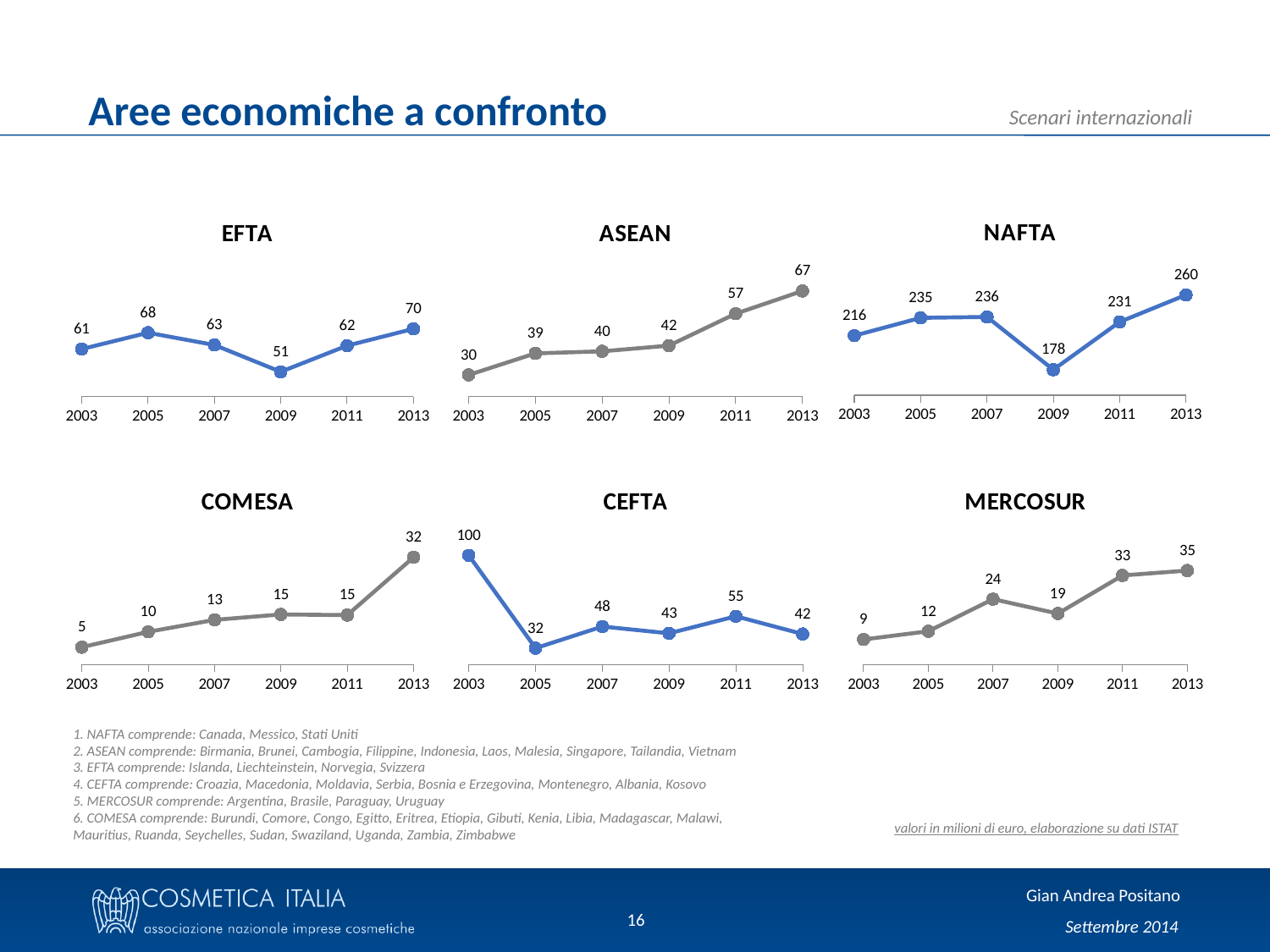
In the COMESA chart, which year has the highest value? 2013 In the CEFTA chart, what is the value for 2003? 100 In the MERCOSUR chart, what is the difference between the 2013 value and the 2003 value? 26 In the ASEAN chart, what is the value for 2013? 67 In the EFTA chart, what is the value for 2009? 51 How many data points are plotted in the ASEAN chart? 6 In the ASEAN chart, do the values rise or fall from 2003 to 2013? rise In the CEFTA chart, is the value for 2011 larger or smaller than the value for 2013? larger In the NAFTA chart, what is the difference between the 2013 value and the 2009 value? 82 How many charts are shown on the slide? 6 What kind of chart is the EFTA chart? line chart In the NAFTA chart, which year has the lowest value? 2009